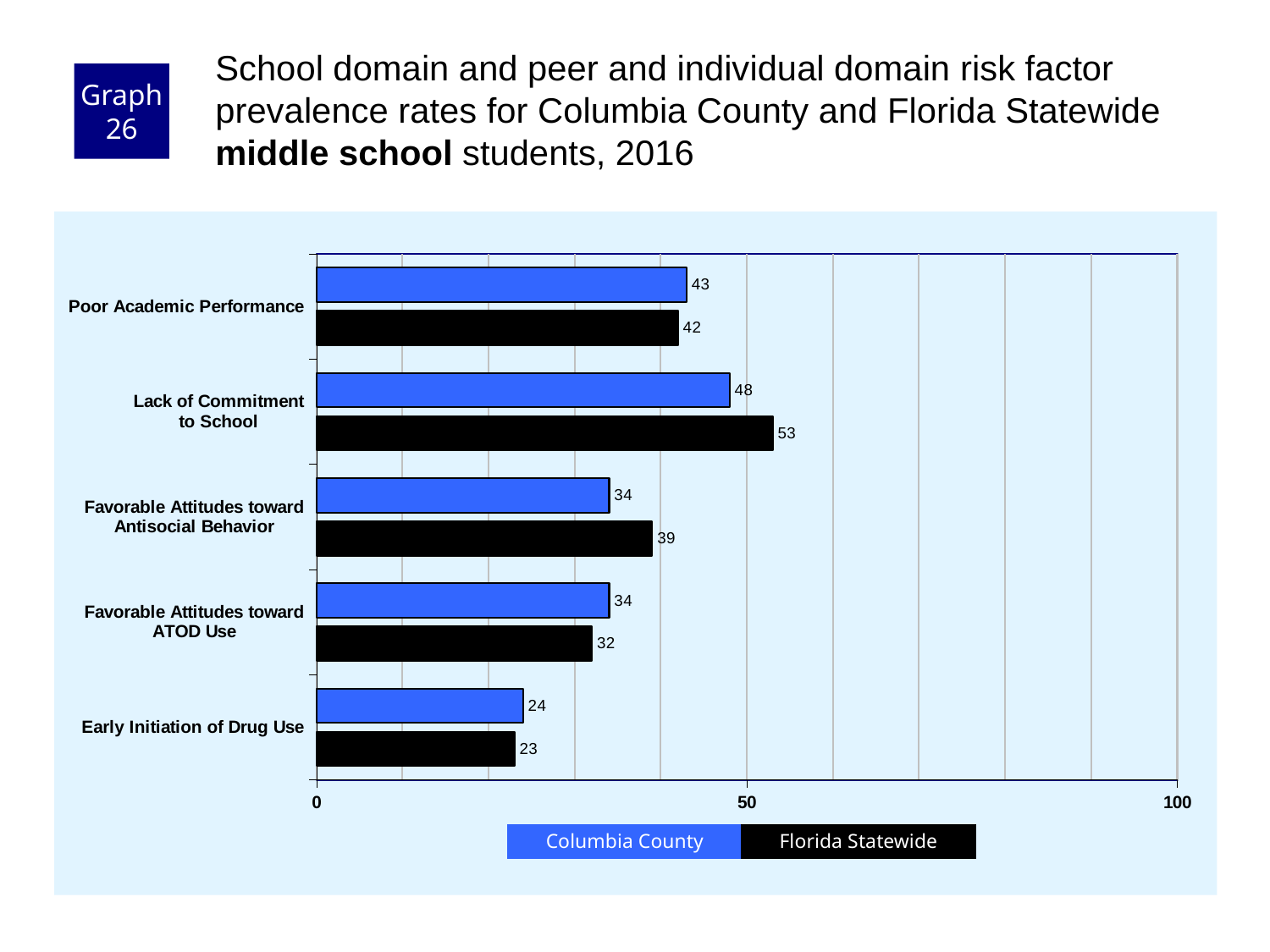
How many series does the legend list? 2 What kind of chart is shown on the slide? Bar chart Which risk factor has the highest Florida Statewide value? Lack of Commitment to School What is the Columbia County value for Poor Academic Performance? 43 What is the difference between the Florida Statewide and Columbia County values for Lack of Commitment to School? 5 What is the Florida Statewide value for Lack of Commitment to School? 53 Is the Florida Statewide value for Lack of Commitment to School greater or less than 50? greater What is the difference between the Florida Statewide and Columbia County values for Favorable Attitudes toward Antisocial Behavior? 5 Which risk factor has the lowest Columbia County value? Early Initiation of Drug Use What is the Columbia County value for Early Initiation of Drug Use? 24 How many risk factor categories are shown on the chart? 5 For Favorable Attitudes toward ATOD Use, which is larger: the Columbia County value or the Florida Statewide value? Columbia County